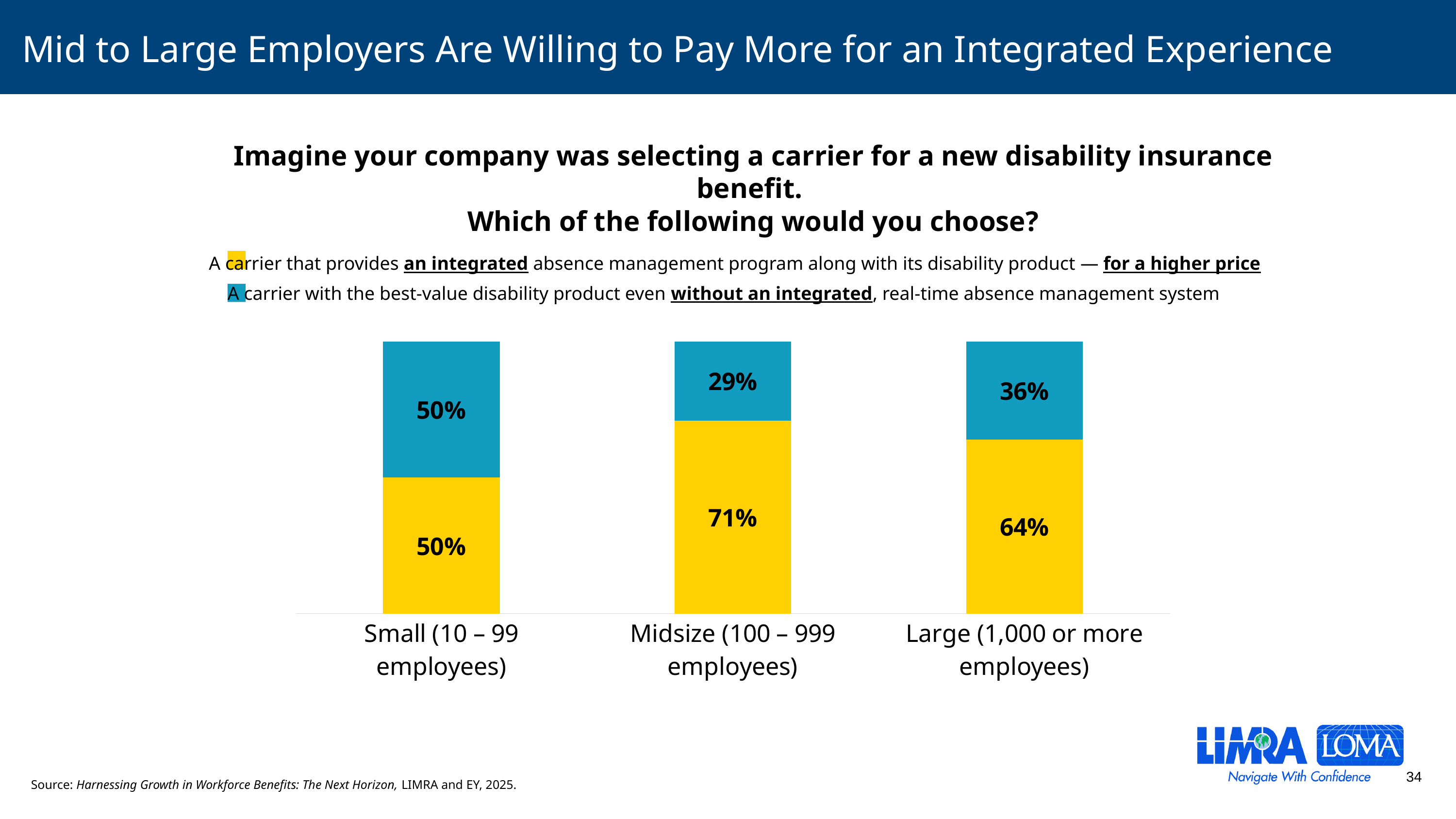
What type of chart is shown on the slide? Stacked bar chart What is the difference between the midsize and large employer shares choosing the integrated absence management program for a higher price? 7% Which employer size group has the lowest share choosing the integrated absence management program for a higher price? Small (10 – 99 employees) Which is larger: the share of large employers choosing the integrated program for a higher price, or the share of small employers choosing it? Large (1,000 or more employees) Which colour represents the carrier that provides an integrated absence management program for a higher price? Yellow Which employer size group has the highest share choosing the integrated absence management program for a higher price? Midsize (100 – 999 employees) What percentage of large employers (1,000 or more employees) would choose a carrier with the best-value disability product without an integrated absence management system? 36% How many employer size categories are shown in the chart? 3 What percentage of midsize employers (100 – 999 employees) would choose a carrier with the best-value disability product without an integrated absence management system? 29% What is the total of the two segments in the bar for small employers (10 – 99 employees)? 100% What percentage of small employers (10 – 99 employees) would choose a carrier that provides an integrated absence management program for a higher price? 50% What percentage of midsize employers (100 – 999 employees) would choose a carrier that provides an integrated absence management program for a higher price? 71%